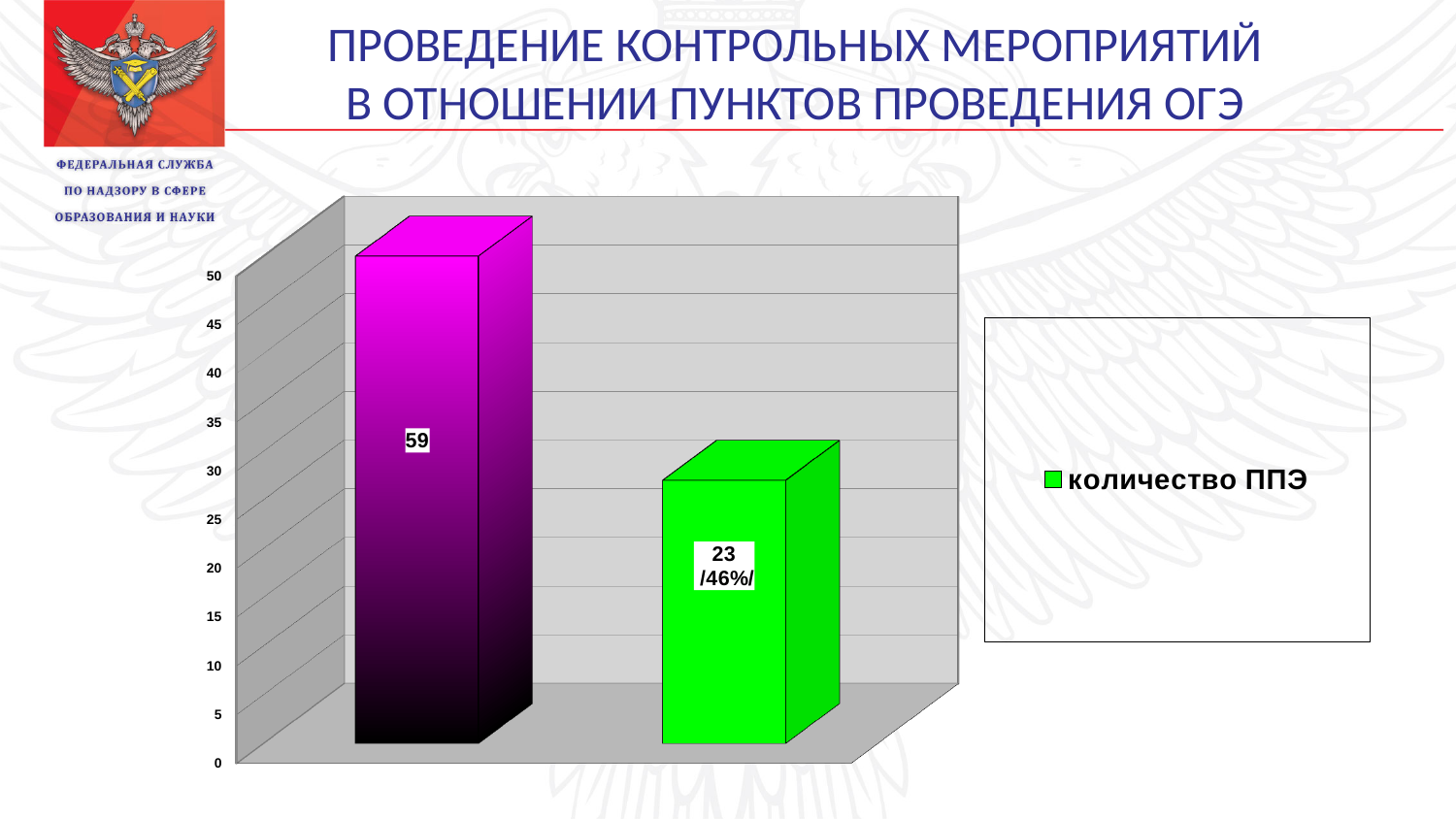
Is the value of the green bar greater or less than 30? less Is the value of the green bar larger or smaller than the value of the magenta bar? smaller What is the legend entry shown next to the chart? количество ППЭ What percentage is printed on the green bar? 46% Which bar is taller, the magenta bar or the green bar? the magenta bar What value is printed on the green bar? 23 How many series does the legend list? 1 Which bar has the lowest value? the green bar What kind of chart is shown on the slide? bar chart How many bars are plotted in the chart? 2 What value is printed on the magenta bar? 59